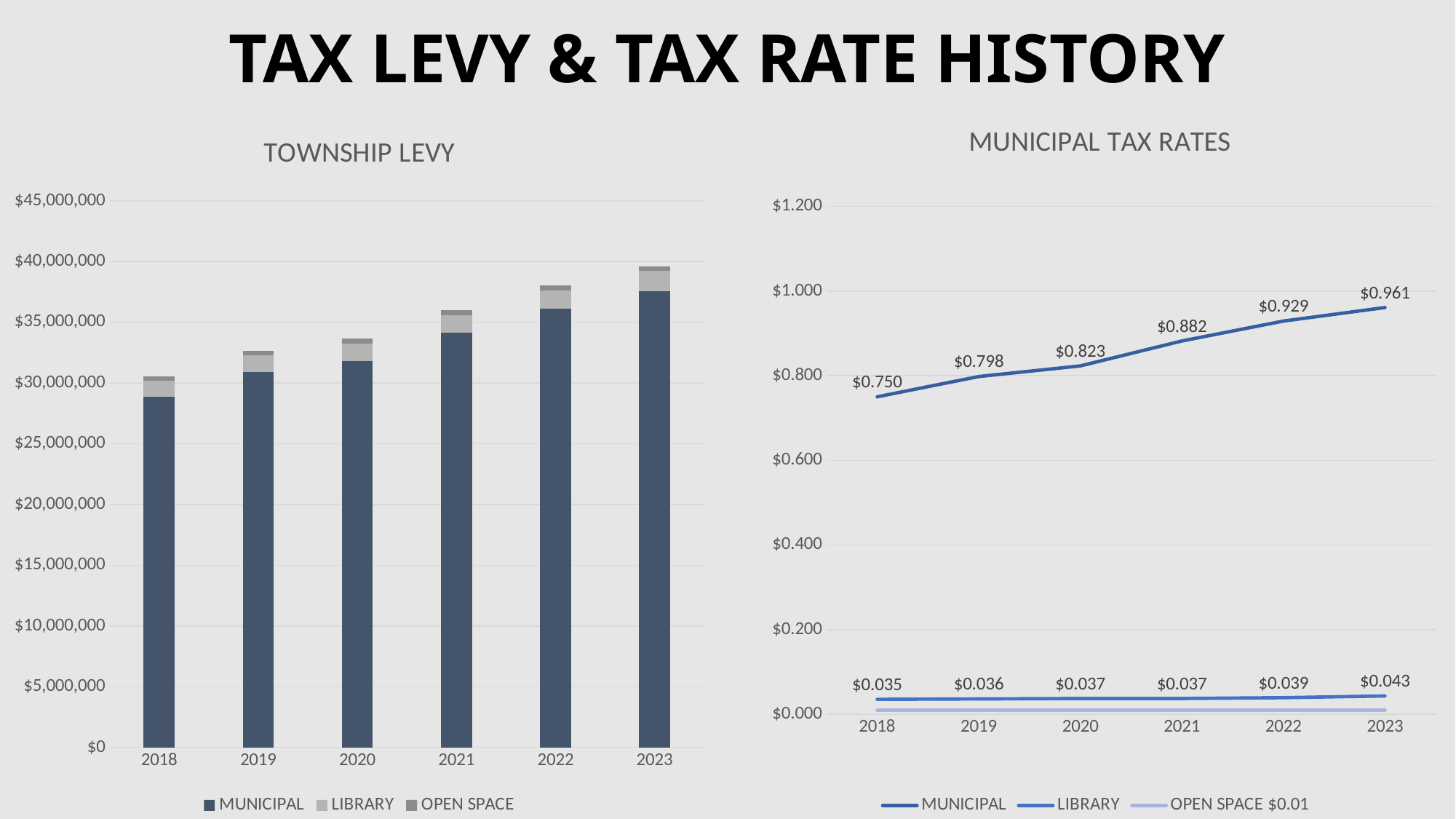
In the TOWNSHIP LEVY chart, is the total stacked bar for 2023 greater or less than $35,000,000? greater In the TOWNSHIP LEVY chart, which year has the tallest stacked bar? 2023 In the MUNICIPAL TAX RATES chart, what is the LIBRARY rate for 2023? $0.043 In the MUNICIPAL TAX RATES chart, which year has the lowest MUNICIPAL rate? 2018 What type of chart is the MUNICIPAL TAX RATES chart on the right? line chart How many series does the legend of the TOWNSHIP LEVY chart list? 3 In the MUNICIPAL TAX RATES chart, what is the MUNICIPAL rate for 2018? $0.750 How many years are shown on the x axis of the TOWNSHIP LEVY chart? 6 In the MUNICIPAL TAX RATES chart, what is the difference between the MUNICIPAL rate in 2023 and in 2018? $0.211 In the TOWNSHIP LEVY chart, do the stacked bars rise or fall from 2018 to 2023? rise What type of chart is the TOWNSHIP LEVY chart on the left? bar chart In the TOWNSHIP LEVY chart, is the total stacked bar for 2018 greater or less than $35,000,000? less